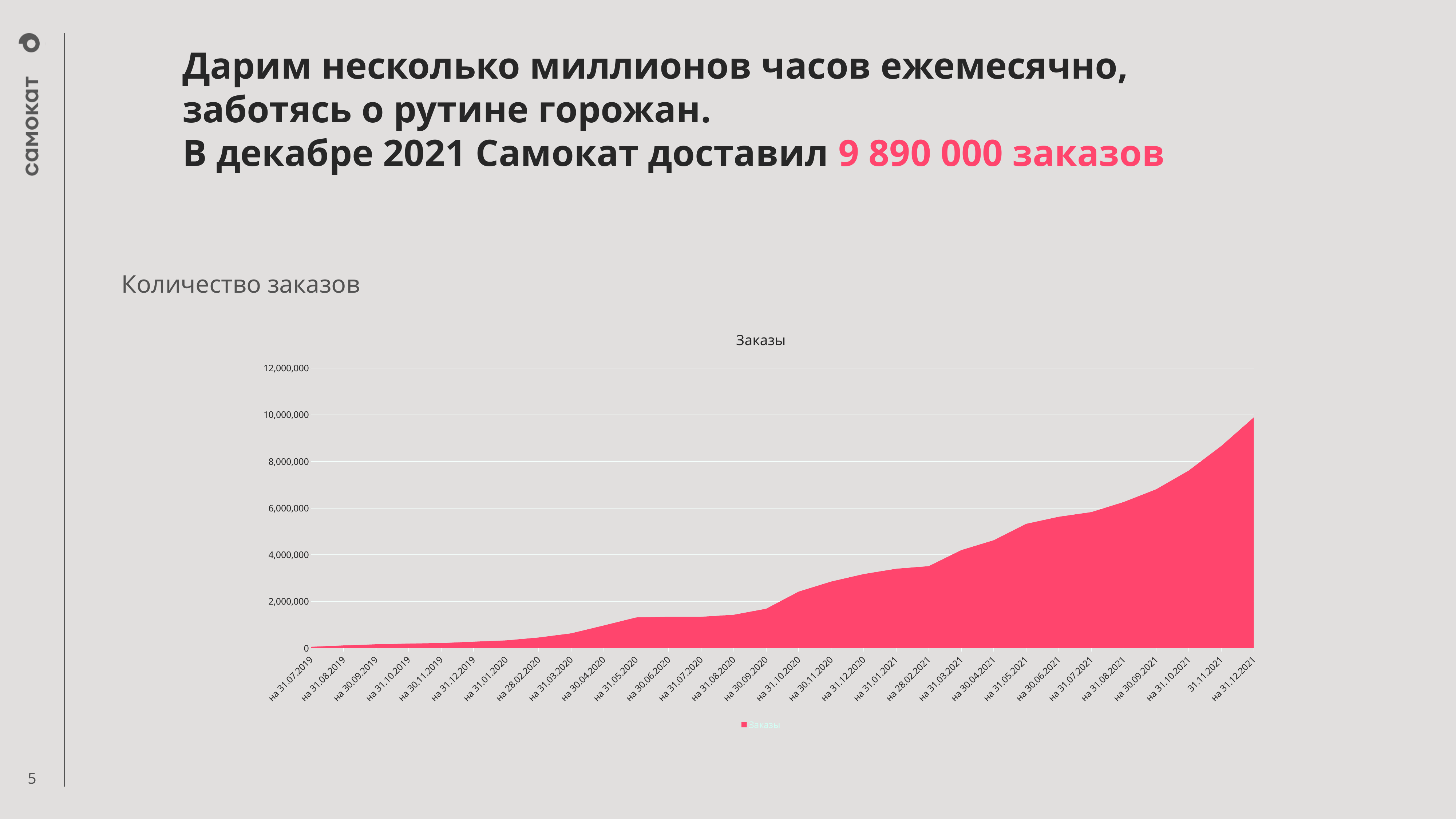
Is the value for 31.12.2021 greater or less than 8,000,000? greater Is the value for 31.01.2021 greater or less than 4,000,000? less Do the values rise or fall along the x axis from 31.07.2019 to 31.12.2021? rise Is the value for 31.05.2021 greater or less than 4,000,000? greater How many series does the legend list? 1 Which date has the highest number of orders? на 31.12.2021 Which date has the lowest number of orders? на 31.07.2019 What is the title of the chart? Заказы Which is larger, the value for 31.12.2020 or the value for 31.12.2021? 31.12.2021 How many data points (dates) are plotted along the x axis? 30 What kind of chart is shown on the slide? area chart